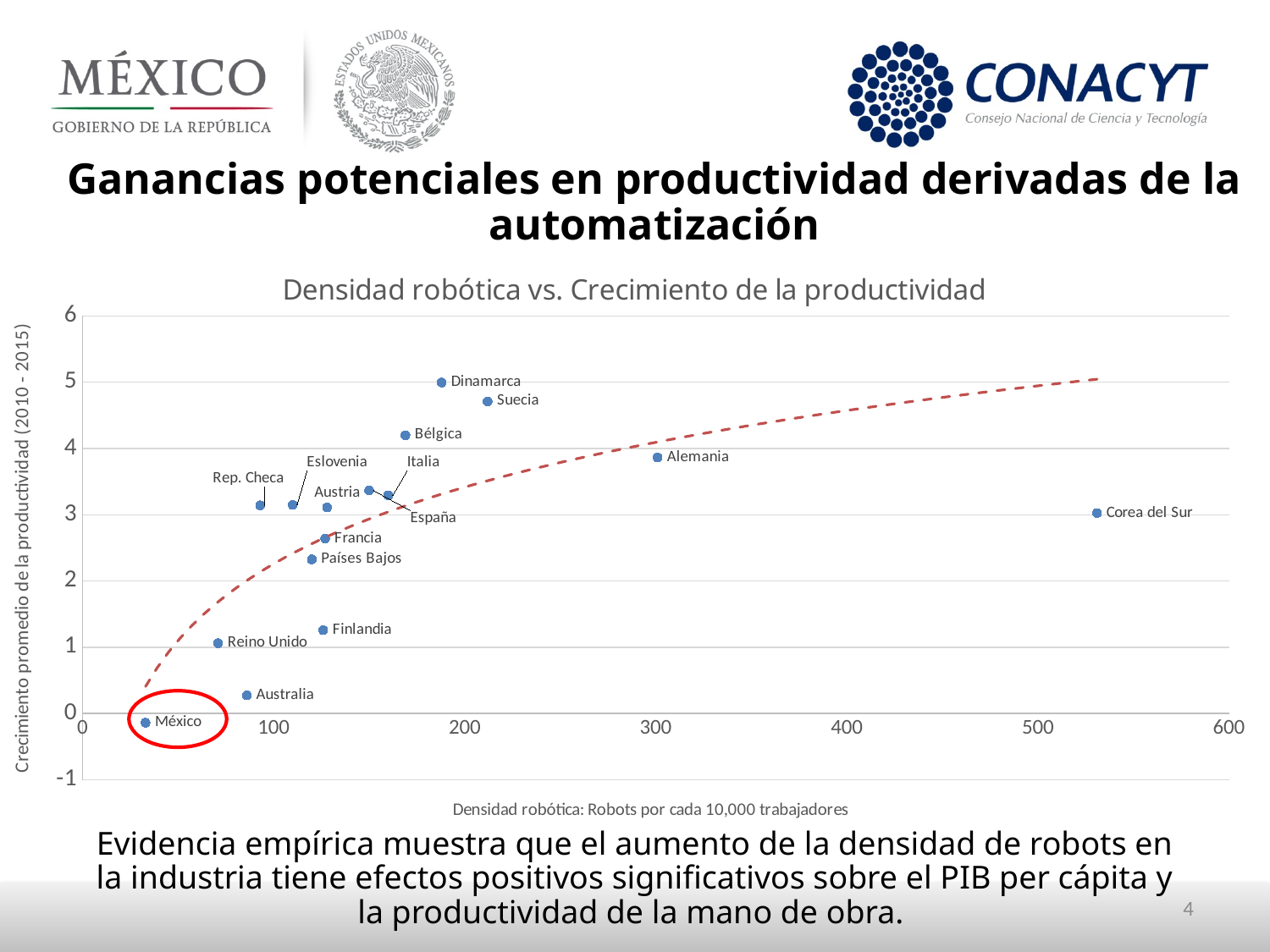
Is the productivity growth for Alemania greater or less than 3? greater Which country has higher robot density, Alemania or Corea del Sur? Corea del Sur Which country has the highest robot density in the chart? Corea del Sur Which country has the lowest average productivity growth in the chart? México Is the robot density for Corea del Sur greater or less than 500? greater Which country has the lowest robot density in the chart? México Which country has the highest average productivity growth in the chart? Dinamarca Is the productivity growth for Australia greater or less than 1? less Which country has higher productivity growth, Dinamarca or Suecia? Dinamarca How many countries are plotted in the chart? 16 What kind of chart is shown on the slide? Scatter chart What is the title of the chart? Densidad robótica vs. Crecimiento de la productividad